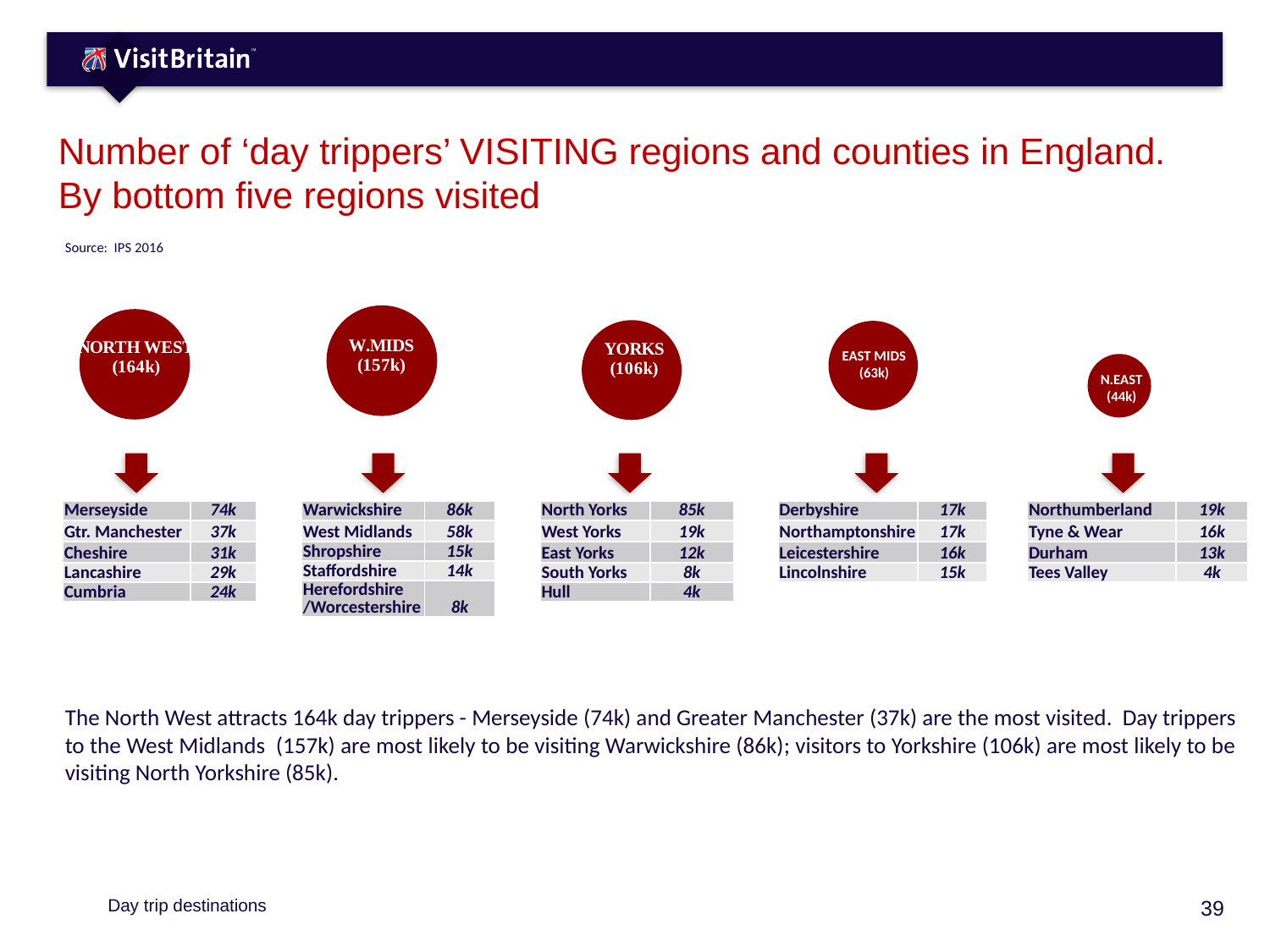
How many counties are listed in the East Midlands table? 4 How many regions are shown on the slide? 5 Which has more day trippers: Merseyside or Gtr. Manchester? Merseyside Which of the five regions shown has the lowest number of day trippers? N.East (44k) What is the difference in day trippers between Merseyside (74k) and Cumbria (24k)? 50k Which county in the North East table has the fewest day trippers? Tees Valley (4k) How many day trippers visited the North East region? 44k Which county in the Yorkshire table has the most day trippers? North Yorks (85k) What is the difference in day trippers between the North West (164k) and the West Midlands (157k)? 7k How many day trippers visited Warwickshire? 86k How many day trippers visited the North West region? 164k Which of the five regions shown has the highest number of day trippers? North West (164k)